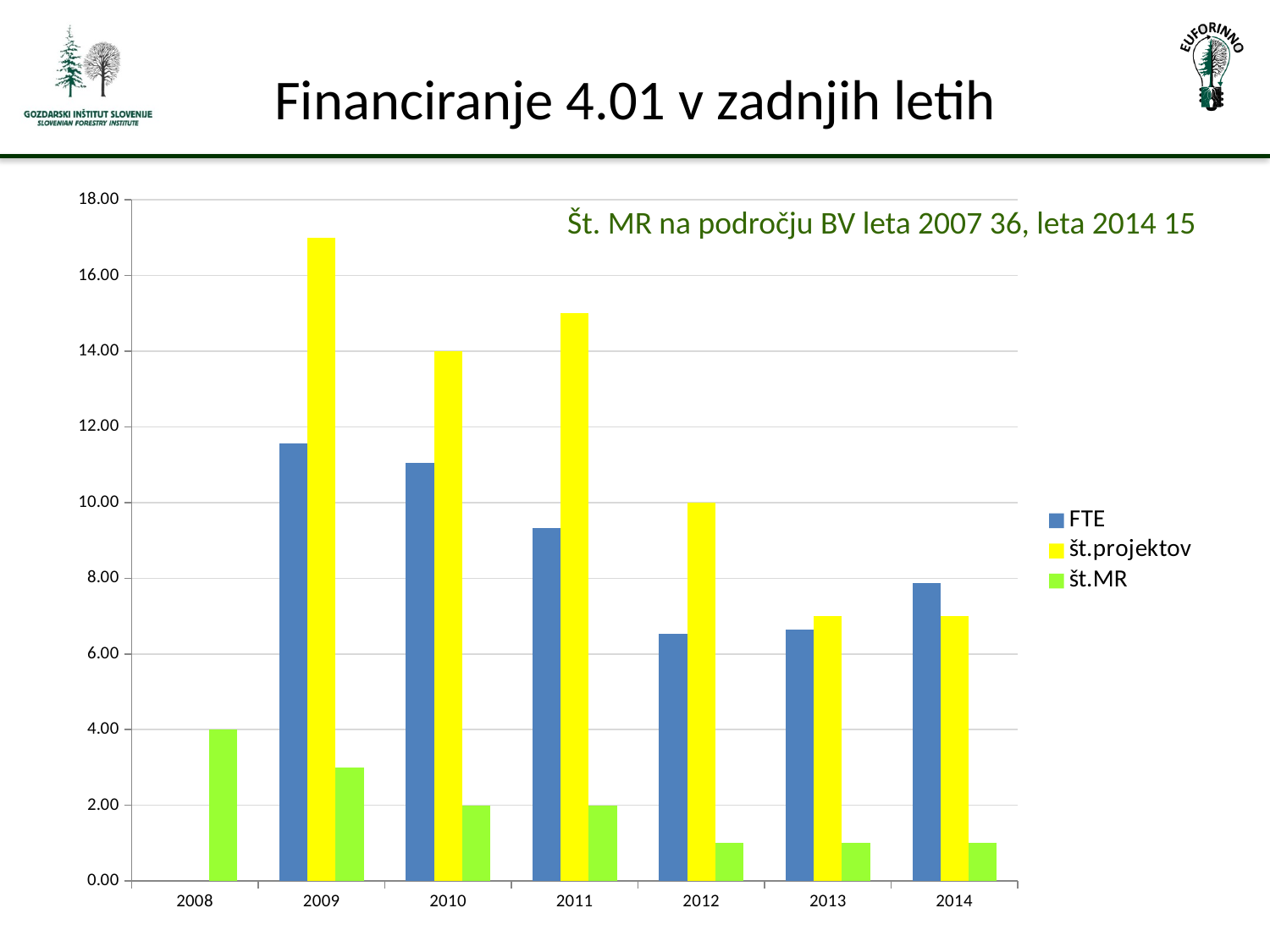
What is the value of št.projektov for 2012? 10.00 Does št.projektov generally rise or fall from 2009 to 2014? fall What kind of chart is shown on the slide? bar chart In which year is št.projektov highest? 2009 What is the value of št.projektov for 2010? 14.00 How many years are shown on the x axis? 7 What is the value of št.MR for 2008? 4.00 In which year is št.MR highest? 2008 Which is larger in 2014, FTE or št.projektov? FTE Is the FTE value for 2009 greater or less than 10.00? greater What is the difference between št.projektov in 2010 and in 2012? 4.00 How many series does the legend list? 3